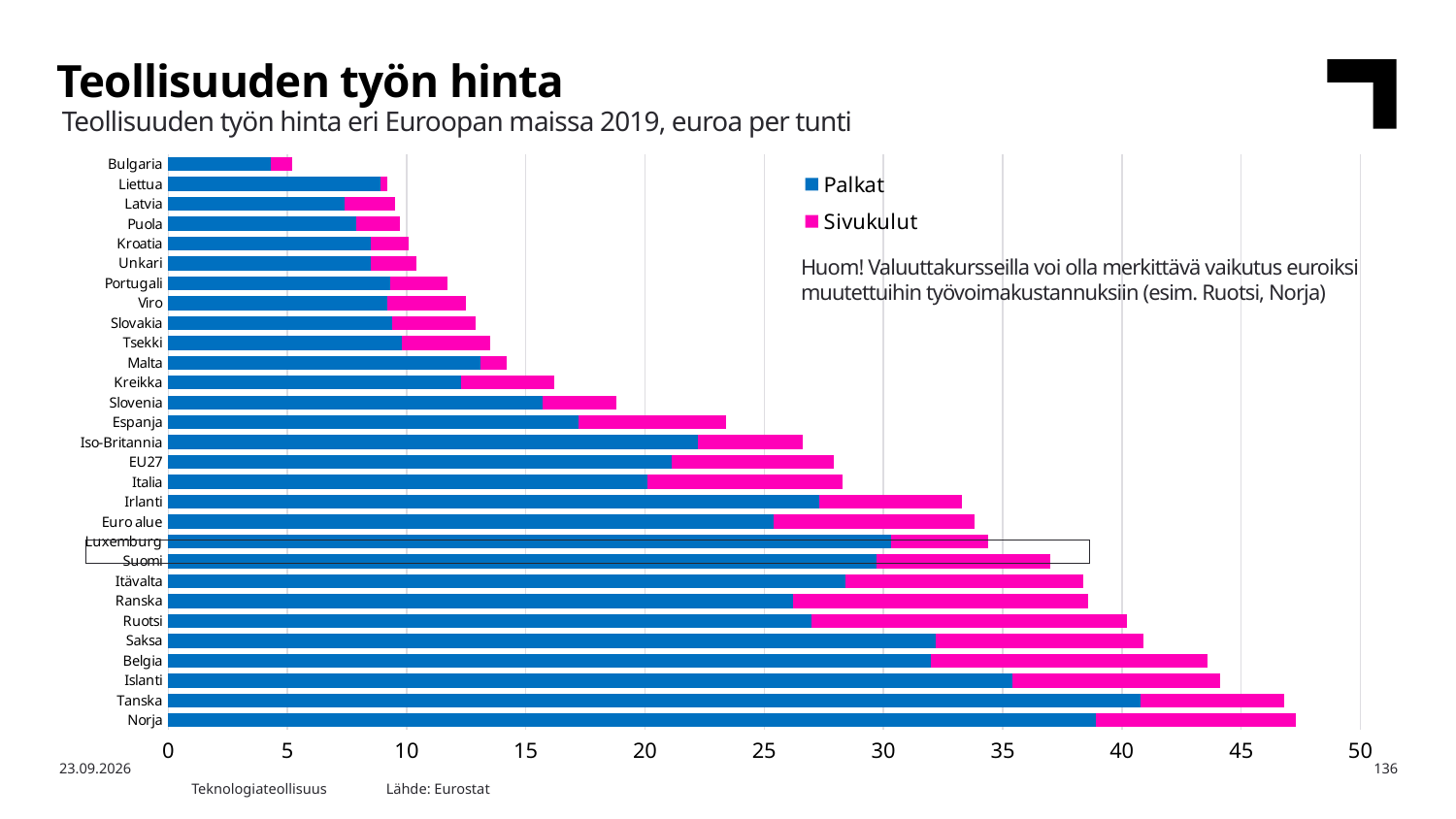
What kind of chart is shown on the slide? Stacked bar chart Which country has the longest total bar? Norja Is the total value for Norja greater or less than 45? greater Is the total value for Espanja greater or less than 25? less Do the total bars get longer or shorter going from the top of the chart to the bottom? Longer Which legend entry is shown in pink? Sivukulut How many series does the legend list? 2 How many countries or regions are shown on the chart? 29 Which country has the shortest total bar? Bulgaria Which has the larger total bar, Irlanti or Italia? Irlanti Is the total value for Suomi greater or less than 35? greater